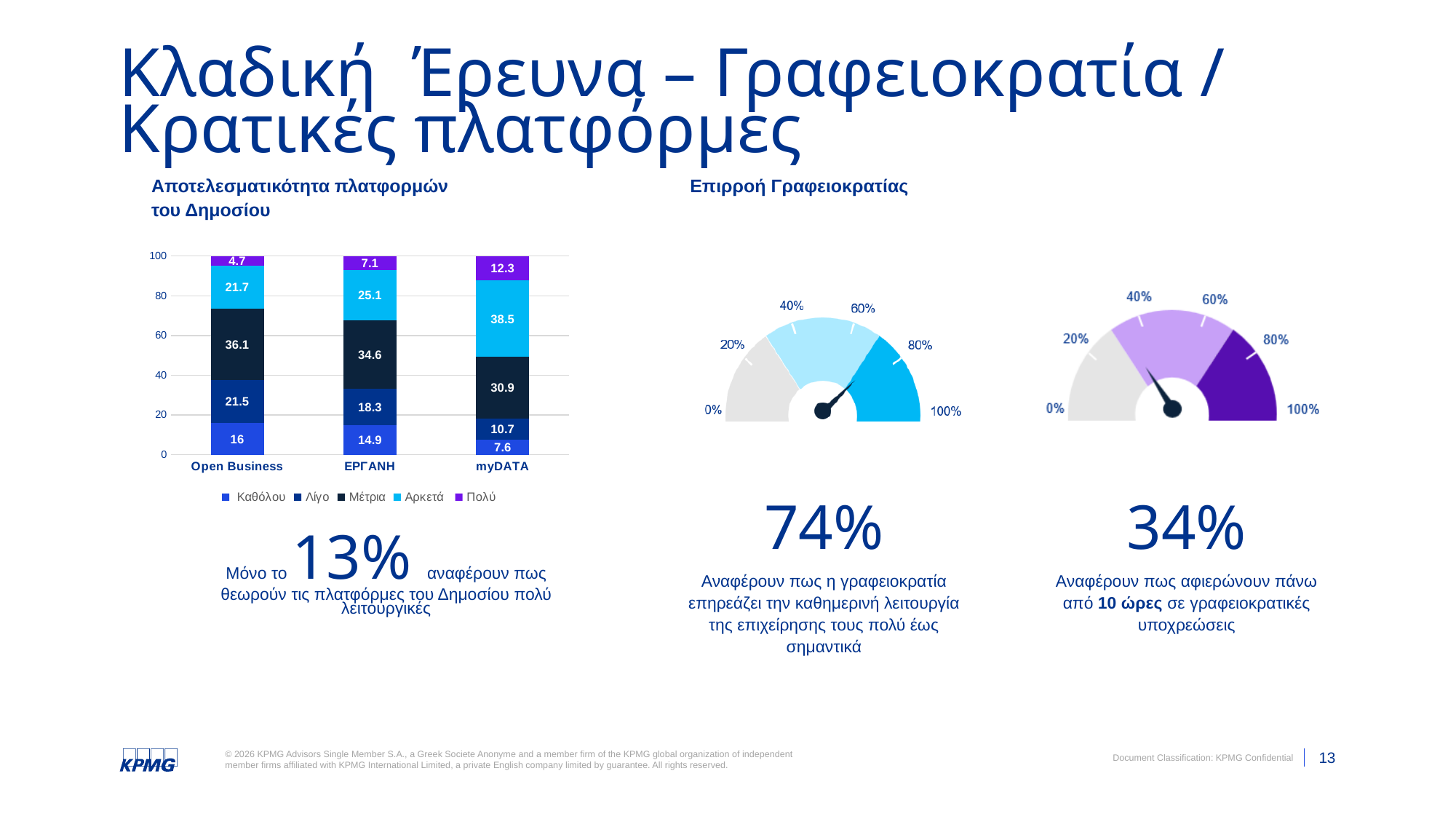
In the stacked bar chart 'Αποτελεσματικότητα πλατφορμών του Δημοσίου', what is the difference between the 'Αρκετά' values for myDATA and Open Business? 16.8 In the stacked bar chart 'Αποτελεσματικότητα πλατφορμών του Δημοσίου', what is the value of 'Καθόλου' for ΕΡΓΑΝΗ? 14.9 What type of chart is used for 'Αποτελεσματικότητα πλατφορμών του Δημοσίου'? Stacked bar chart In the stacked bar chart 'Αποτελεσματικότητα πλατφορμών του Δημοσίου', which platform has the highest 'Πολύ' value? myDATA In the stacked bar chart 'Αποτελεσματικότητα πλατφορμών του Δημοσίου', what is the value of 'Μέτρια' for Open Business? 36.1 In the stacked bar chart 'Αποτελεσματικότητα πλατφορμών του Δημοσίου', what is the value of 'Αρκετά' for myDATA? 38.5 In the right gauge chart under 'Επιρροή Γραφειοκρατίας', what percentage is shown? 34% In the stacked bar chart 'Αποτελεσματικότητα πλατφορμών του Δημοσίου', which is larger: the 'Λίγο' value for Open Business or for ΕΡΓΑΝΗ? Open Business In the left gauge chart under 'Επιρροή Γραφειοκρατίας', what percentage is shown? 74% In the stacked bar chart 'Αποτελεσματικότητα πλατφορμών του Δημοσίου', how many series does the legend list? 5 In the stacked bar chart 'Αποτελεσματικότητα πλατφορμών του Δημοσίου', how many platforms are shown on the x axis? 3 In the stacked bar chart 'Αποτελεσματικότητα πλατφορμών του Δημοσίου', which platform has the lowest 'Καθόλου' value? myDATA